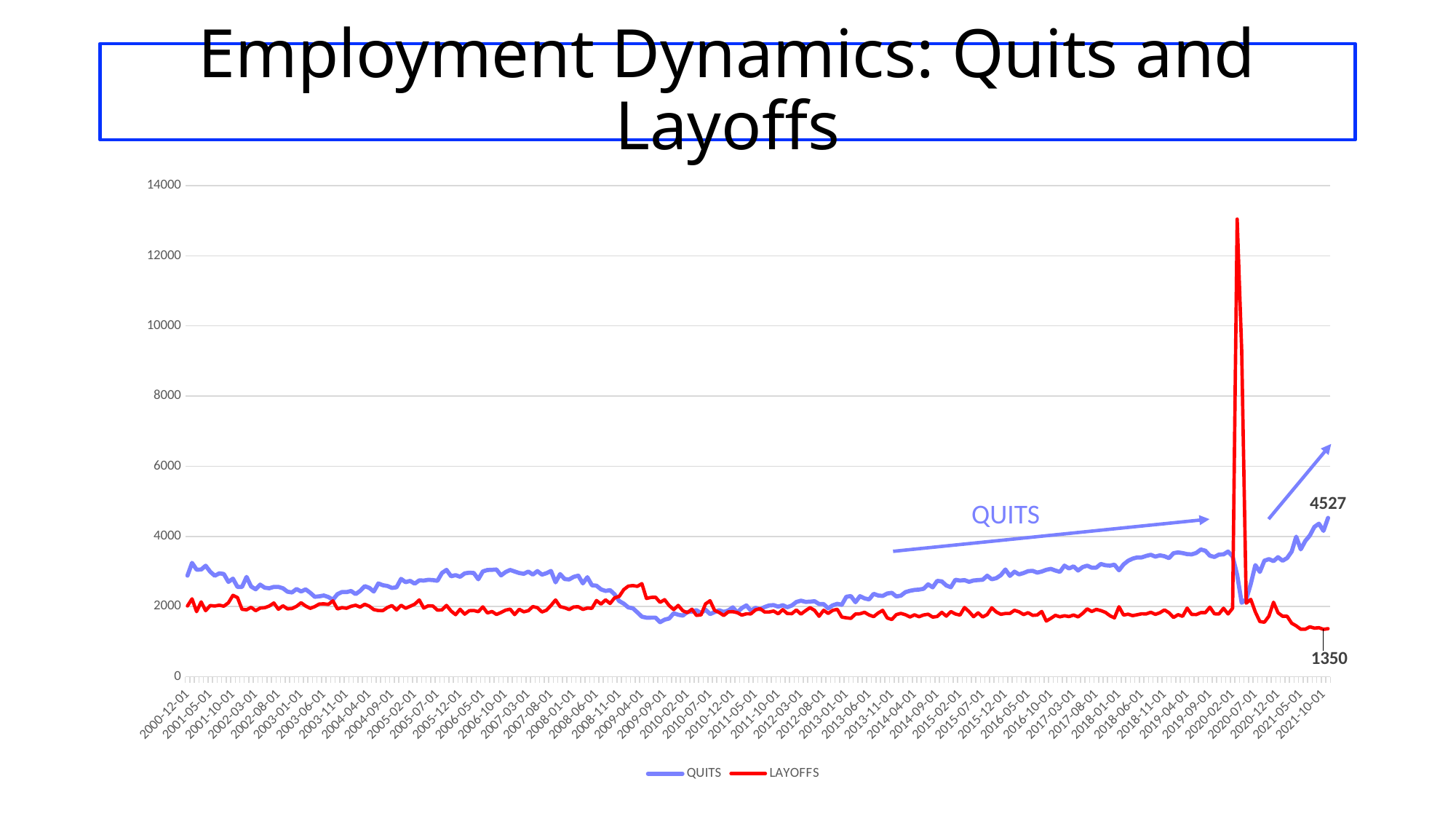
What is the title of the slide? Employment Dynamics: Quits and Layoffs What colour is the LAYOFFS line in the legend? red Is the value of QUITS at 2000-12-01 greater or less than 2000? greater Which series reaches the highest value anywhere on the chart? LAYOFFS What is the labelled final value of the LAYOFFS series? 1350 At the end of the series, which is larger: QUITS or LAYOFFS? QUITS Does the QUITS series generally rise or fall between 2013 and 2019? rise Is the peak value of the LAYOFFS series greater or less than 12000? greater What is the labelled final value of the QUITS series? 4527 How many series does the legend list? 2 What kind of chart is shown on the slide? line chart What is the difference between the labelled final values of QUITS (4527) and LAYOFFS (1350)? 3177